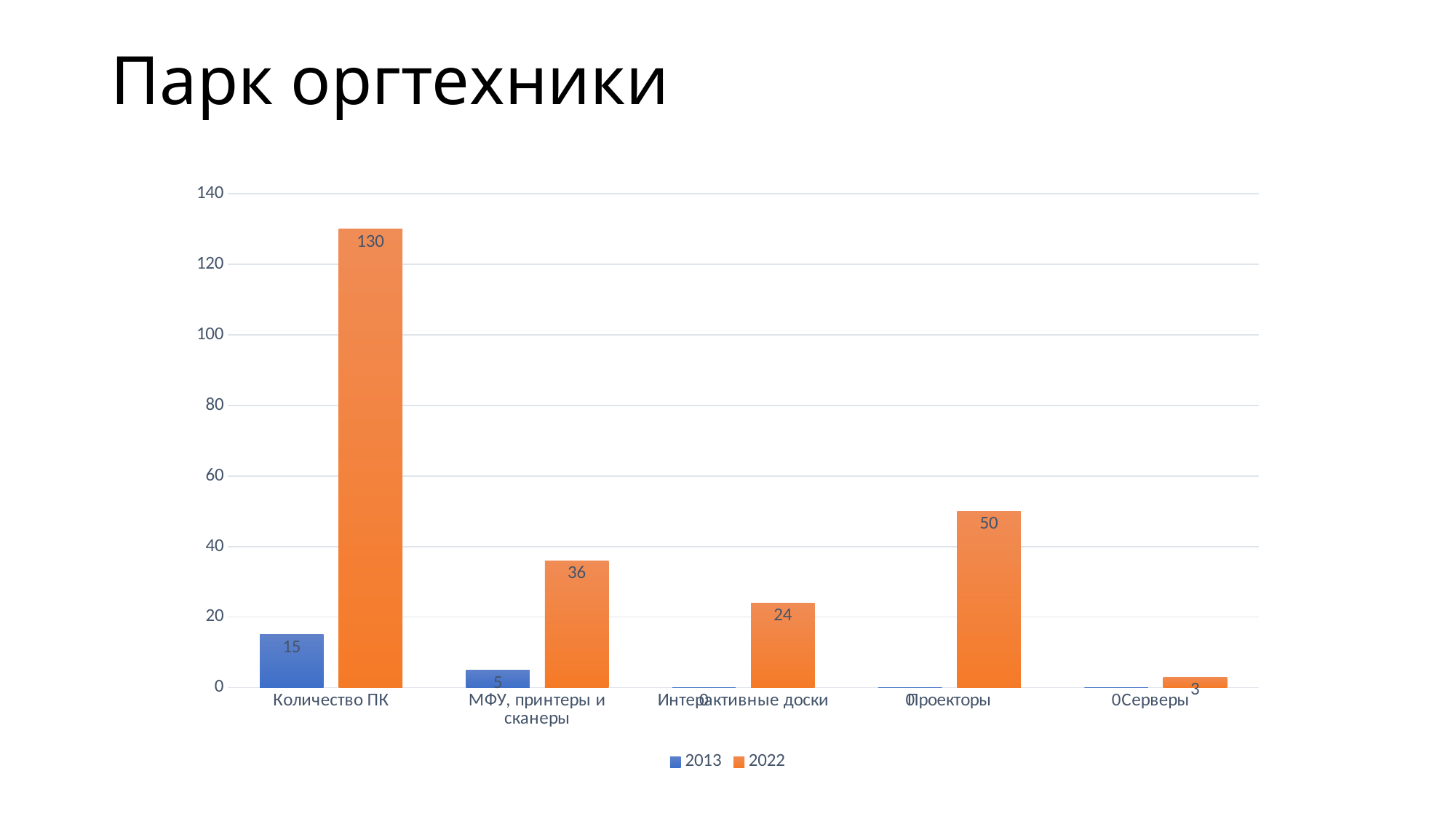
How many categories are shown on the x axis? 5 What is the value for Количество ПК in 2013? 15 What is the value for МФУ, принтеры и сканеры in 2013? 5 What type of chart is shown on the slide? bar chart What is the value for Серверы in 2022? 3 How many series does the legend list? 2 Which is larger in 2022: Интерактивные доски or Проекторы? Проекторы What is the value for Проекторы in 2022? 50 What is the difference between the 2022 and 2013 values for Количество ПК? 115 Which category has the lowest value in the 2022 series? Серверы Which category has the highest value in the 2022 series? Количество ПК What is the value for Количество ПК in 2022? 130